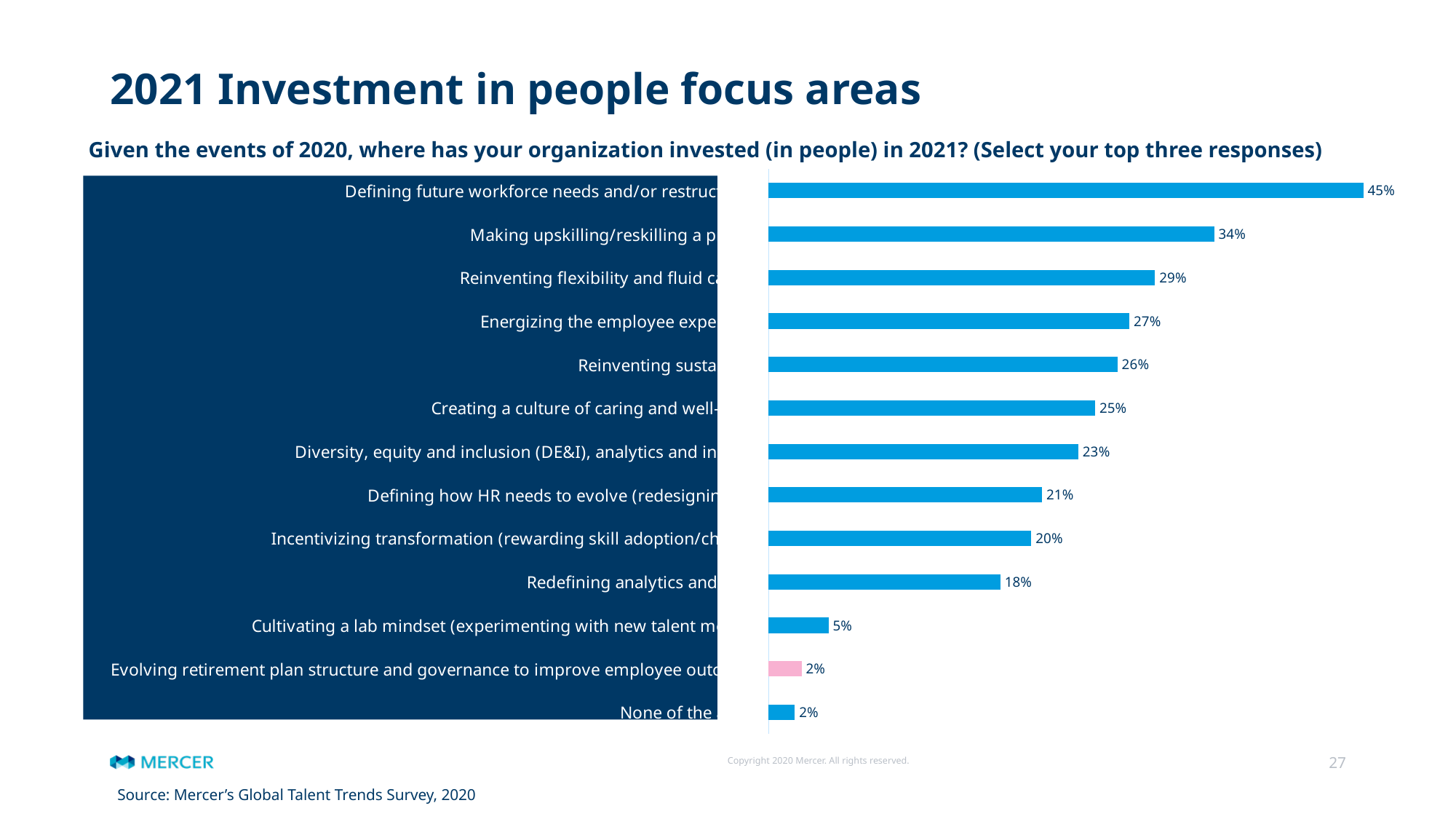
What is the lowest value shown in the chart? 2% What is the value for 'Cultivating a lab mindset'? 5% What is the difference in percentage points between 'Defining future workforce needs' (45%) and 'Making upskilling/reskilling' (34%)? 11 percentage points Which bar in the chart is coloured pink instead of blue? Evolving retirement plan structure and governance to improve employee outcomes Which has a larger value: 'Reinventing flexibility and fluid careers' or 'Energizing the employee experience'? Reinventing flexibility and fluid careers What kind of chart is shown on the slide? bar chart What is the value for 'Evolving retirement plan structure and governance'? 2% How many categories (bars) does the chart show? 13 What is the value for 'Making upskilling/reskilling a priority'? 34% What is the value for 'Creating a culture of caring and well-being'? 25% Which category has the highest value in the chart? Defining future workforce needs and/or restructuring What is the value for the top bar, 'Defining future workforce needs'? 45%